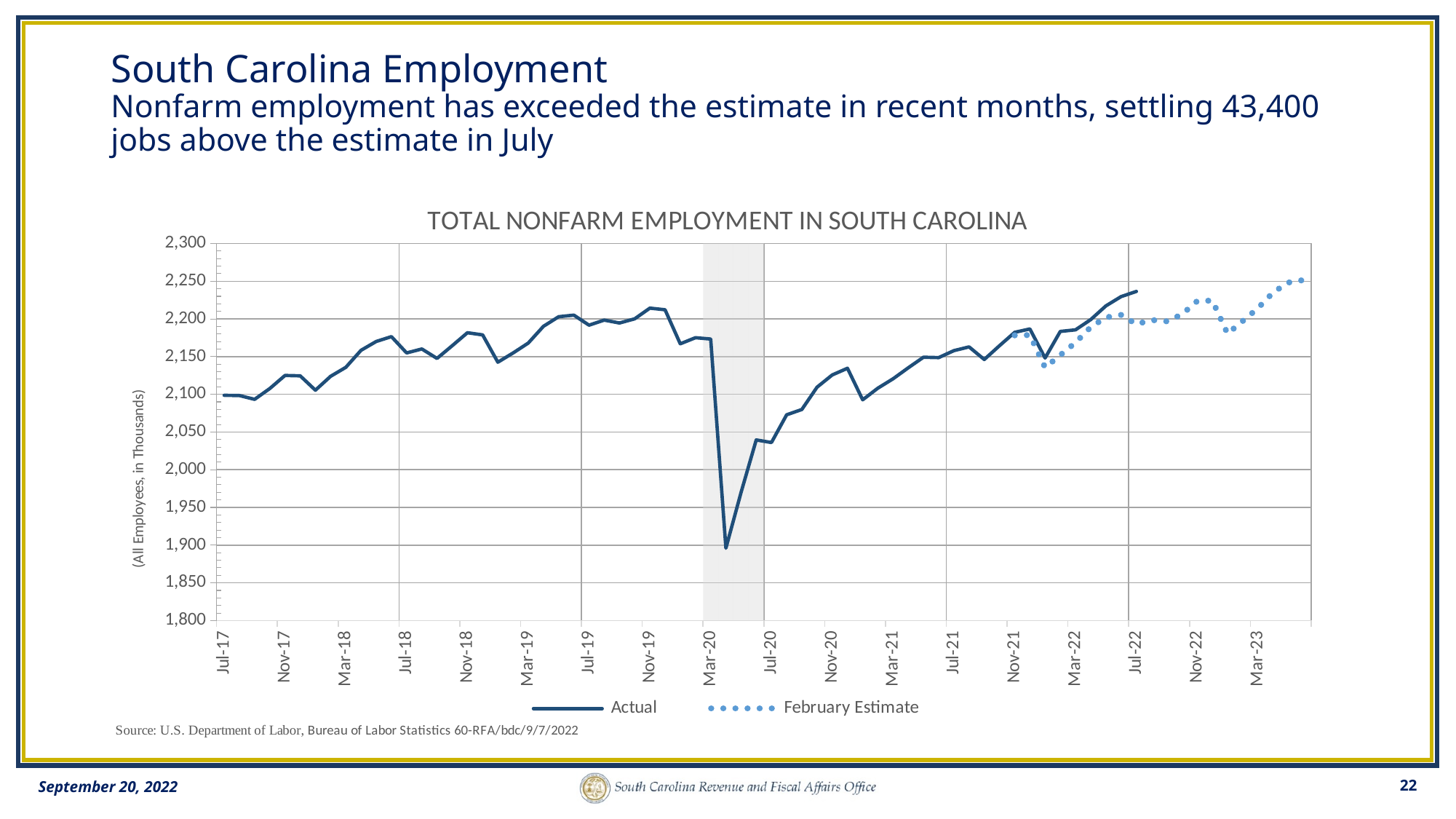
Is the Actual value for Jul-20 greater or less than 2,000? greater What kind of chart is shown on the slide? line chart Is the Actual value for Jul-17 greater or less than 2,150? less Is the Actual value for Jul-22 greater or less than 2,200? greater Does the Actual series generally rise or fall between Jul-20 and Jul-22? rise At Jul-22, which series has the higher value, Actual or February Estimate? Actual What is the title of the chart? TOTAL NONFARM EMPLOYMENT IN SOUTH CAROLINA How many series does the chart legend list? 2 Which series is drawn as a dotted line in the chart? February Estimate Which is larger, the Actual value for Jul-22 or the Actual value for Jul-17? Jul-22